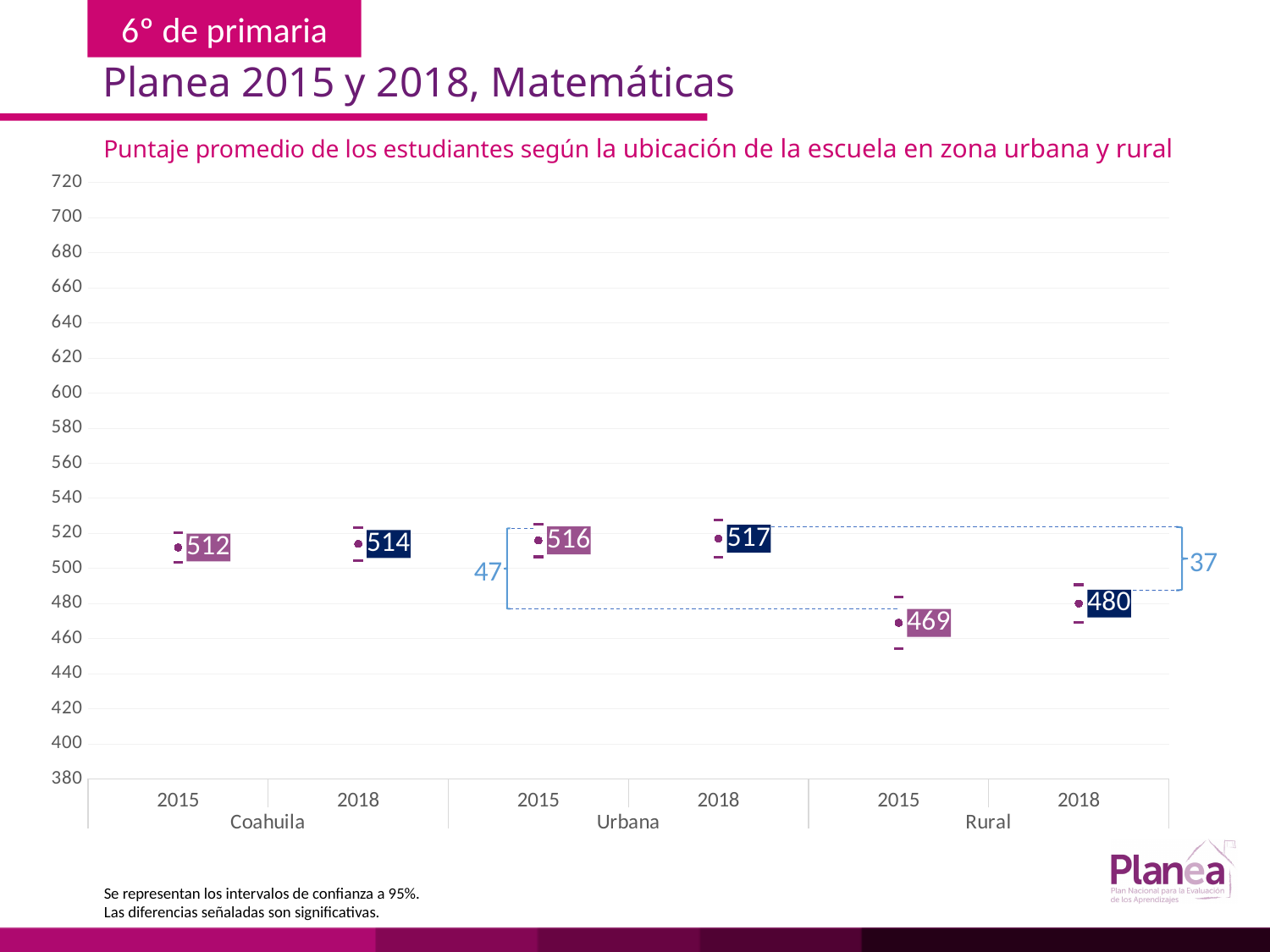
What is the average score for Urbana schools in 2018? 517 What is the average score for Rural schools in 2018? 480 What is the average score for Rural schools in 2015? 469 Which is larger, the Urbana 2015 score or the Rural 2015 score? Urbana 2015 How many data points are plotted on the chart? 6 Which group and year has the highest average score? Urbana 2018 What is the difference between the Urbana and Rural scores in 2018, as annotated on the chart? 37 What is the average score for Coahuila in 2018? 514 What is the difference between the Rural scores in 2018 and 2015? 11 What is the average score for Urbana schools in 2015? 516 What is the average score for Coahuila in 2015? 512 Which group and year has the lowest average score? Rural 2015